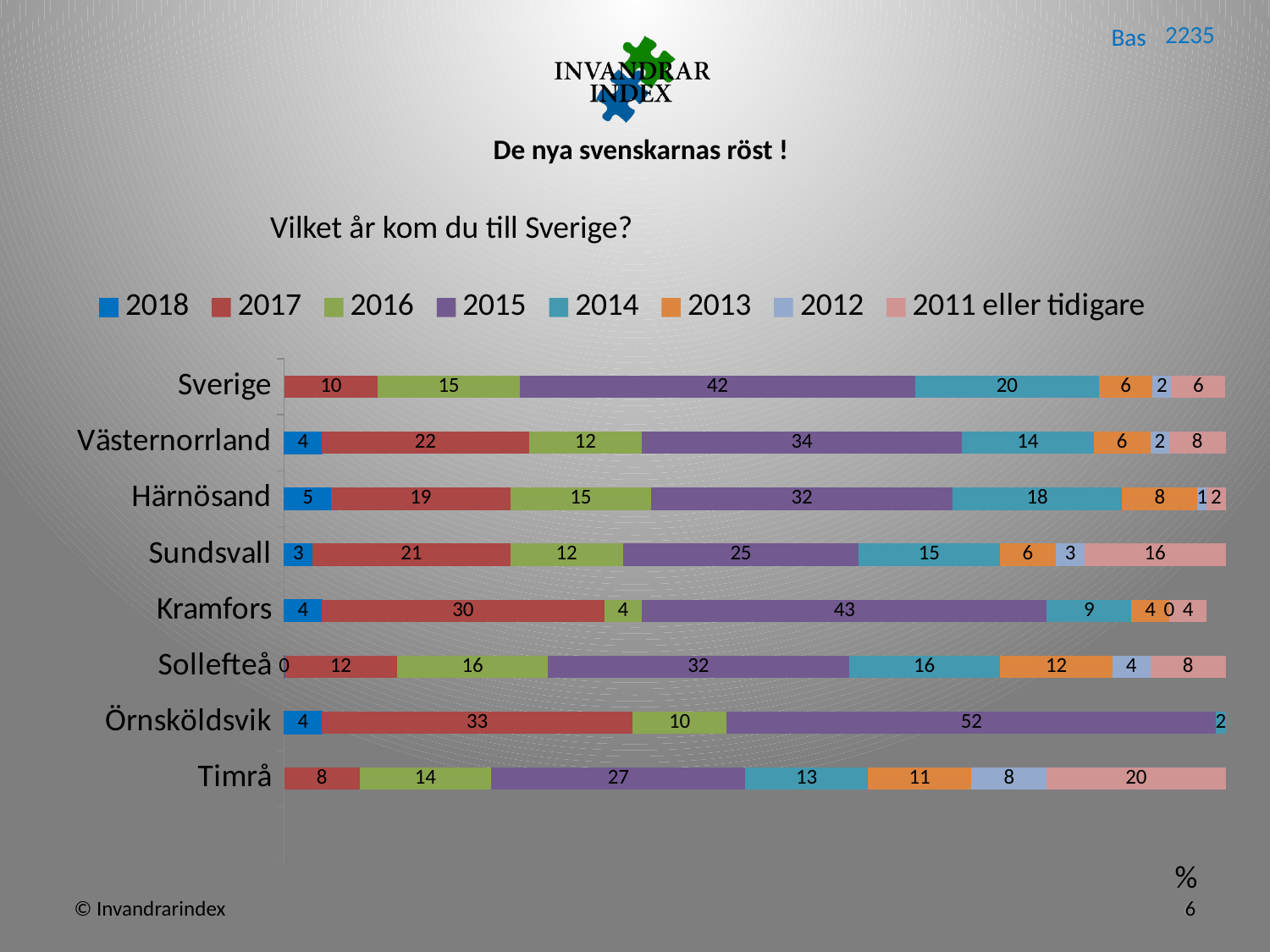
What is the value for 2011 eller tidigare for Timrå? 20 What is the value for 2017 for Örnsköldsvik? 33 What type of chart is shown on the slide? stacked bar chart How many categories (regions) are shown on the chart? 8 Which category has the lowest value for 2015? Sundsvall How many series does the legend list? 8 What is the difference between the 2017 values for Kramfors and Sollefteå? 18 Which is larger, the 2016 value for Sollefteå or the 2016 value for Kramfors? Sollefteå What is the value for 2015 for Sverige? 42 What is the title of the chart? Vilket år kom du till Sverige? Which category has the highest value for 2015? Örnsköldsvik What is the value for 2014 for Härnösand? 18